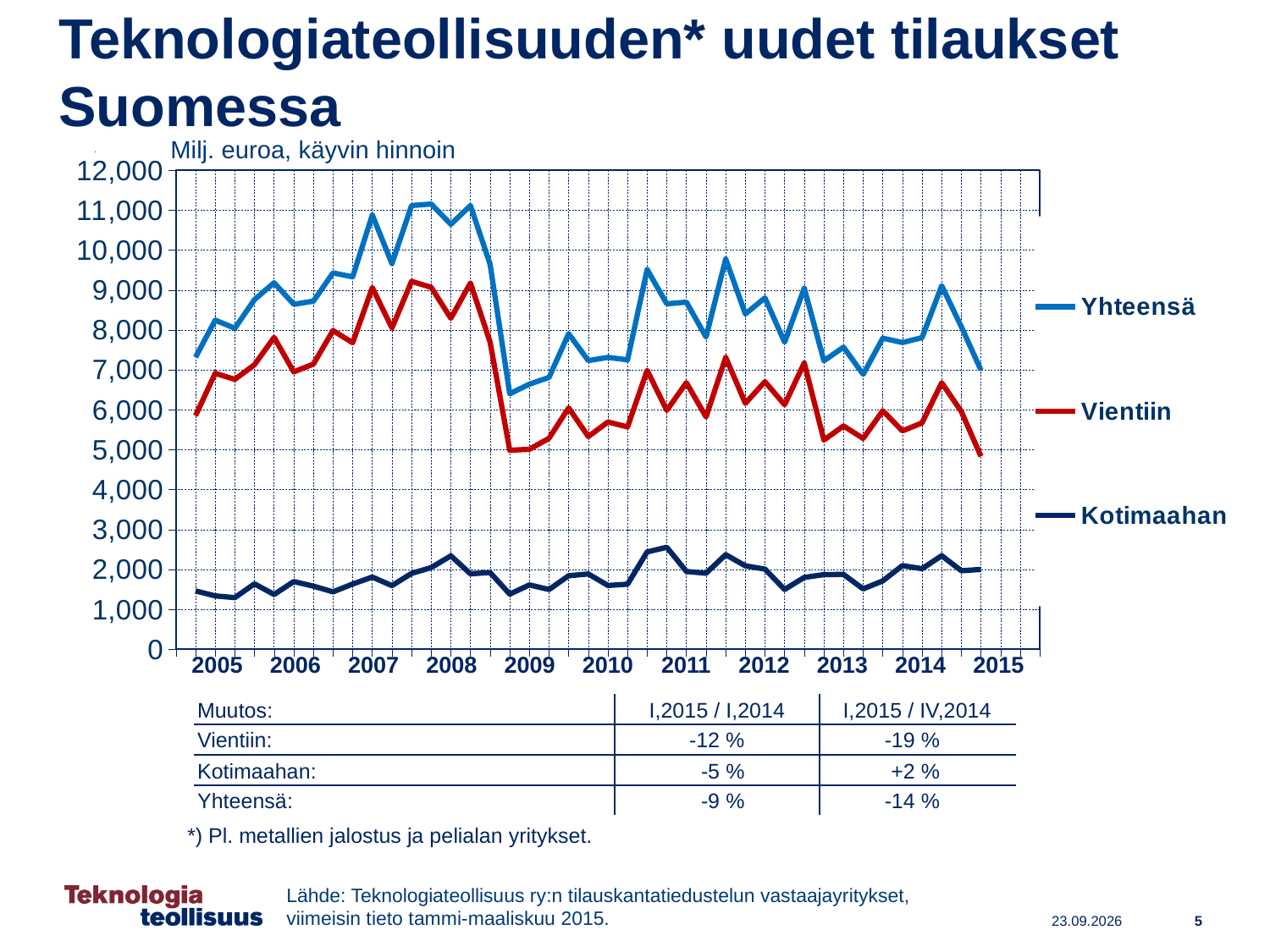
Is the lowest value of Yhteensä in 2009 greater or less than 7,000? less How many year labels are shown on the x axis of the chart? 11 Which series is shown in red in the chart? Vientiin Is the peak value of Yhteensä around 2008 greater or less than 10,000? greater What kind of chart is shown on the slide? Line chart Which series has the highest values throughout the chart? Yhteensä Is the value for Kotimaahan ever greater or less than 3,000 over the whole period? less Which series is larger at the end of the chart in 2015, Vientiin or Kotimaahan? Vientiin What unit is stated above the chart's y axis? Milj. euroa, käyvin hinnoin Which series has the lowest values throughout the chart? Kotimaahan Does the Yhteensä series rise or fall from 2014 to 2015? Fall How many series does the chart legend list? 3